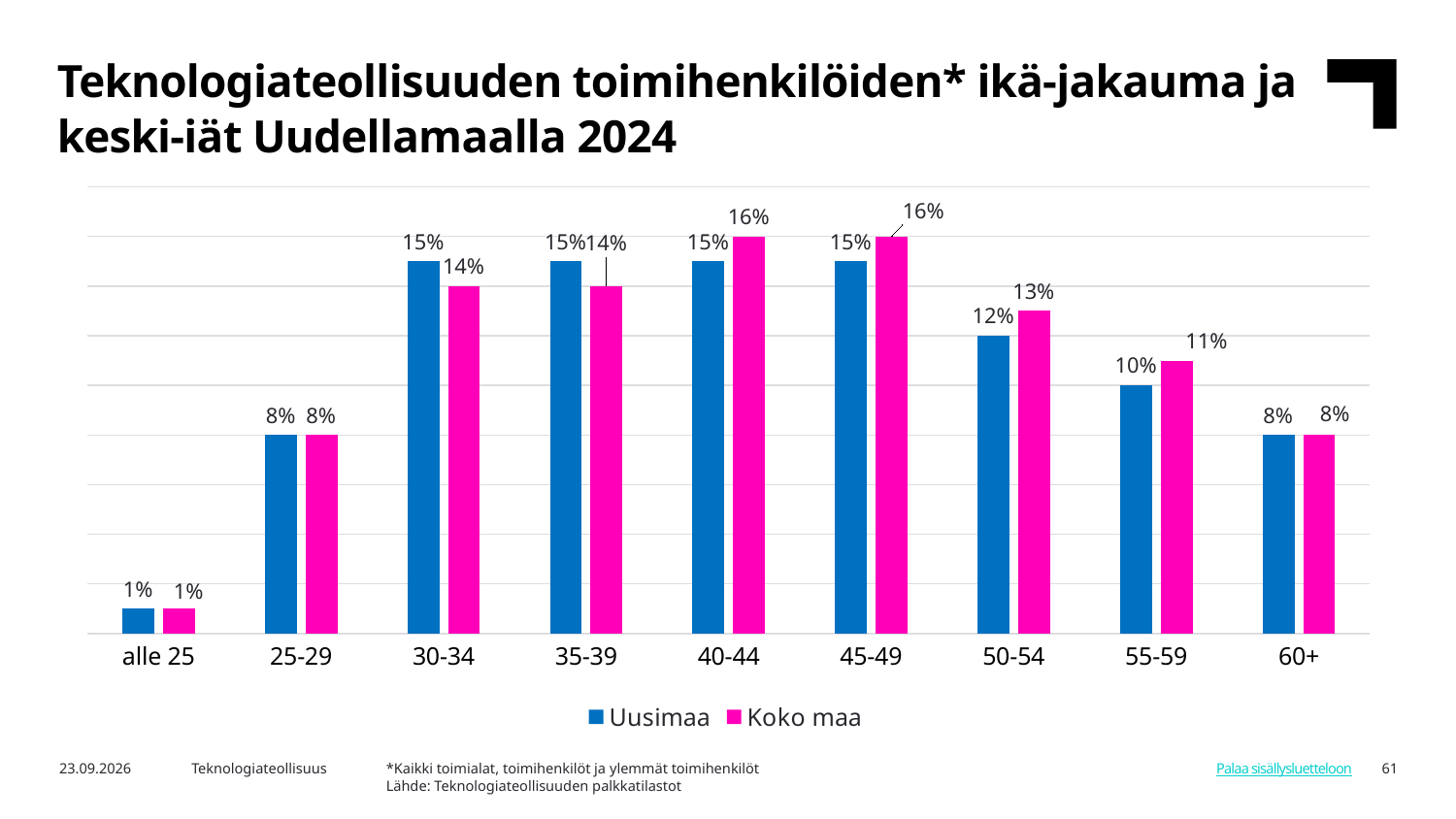
In the 35-39 age group, which series has the larger value, Uusimaa or Koko maa? Uusimaa What is the value for Uusimaa in the 25-29 age group? 8% What is the difference between the Koko maa and Uusimaa values in the 40-44 age group? 1% How many age groups are shown on the x axis? 9 How many series does the legend list? 2 What is the value for Koko maa in the 30-34 age group? 14% Which age group has the lowest value for Koko maa? alle 25 What is the difference between the Uusimaa values for 30-34 and 50-54? 3% What is the value for Uusimaa in the 50-54 age group? 12% Which age group has the lowest value for Uusimaa? alle 25 What is the value for Koko maa in the 55-59 age group? 11% What kind of chart is shown on the slide? Bar chart